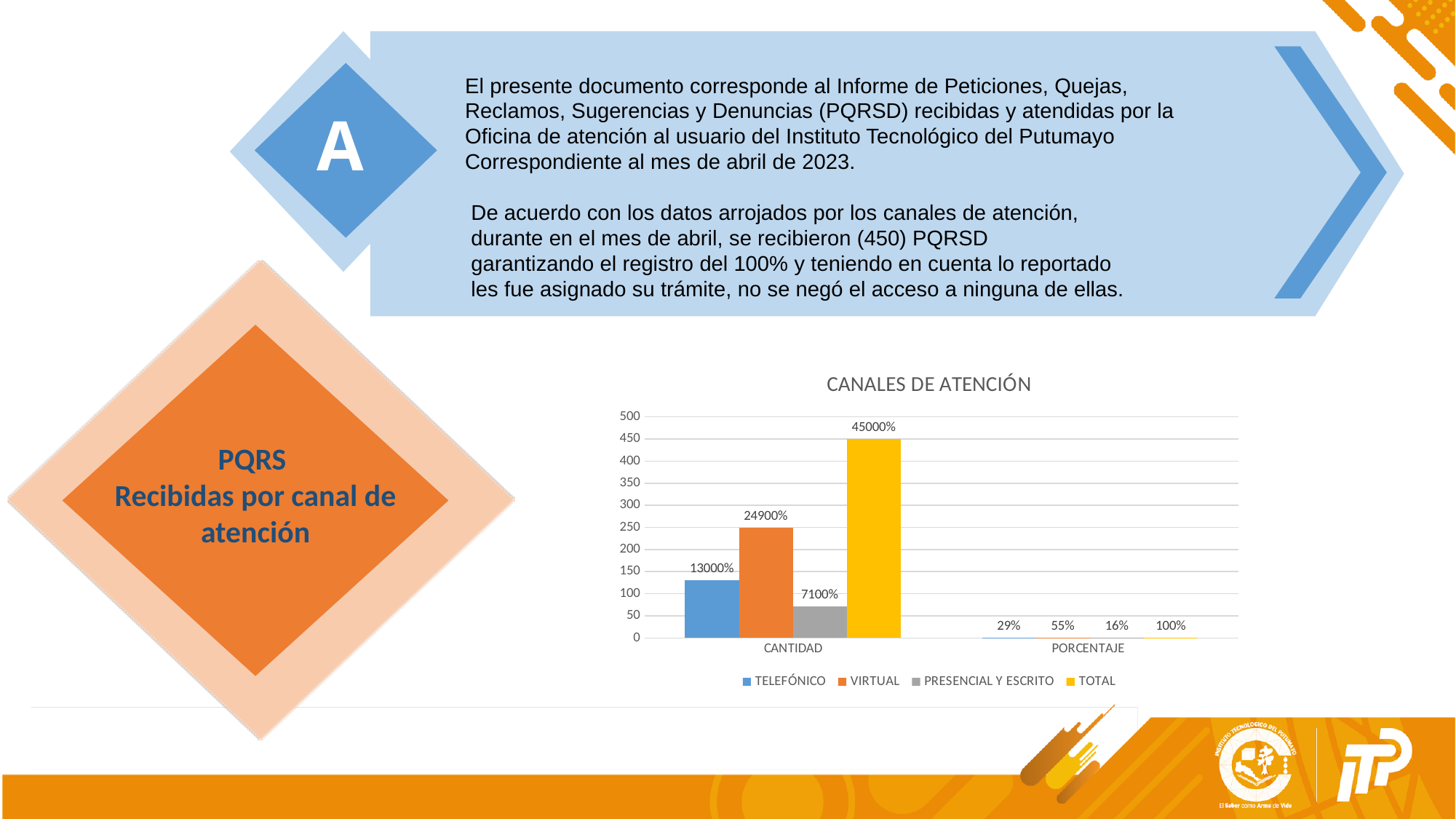
How many series does the chart legend list? 4 What is the data label for TOTAL in the CANTIDAD category? 45000% In the CANTIDAD category, which bar is taller: TELEFÓNICO or VIRTUAL? VIRTUAL What is the data label for VIRTUAL in the CANTIDAD category? 24900% What is the data label for VIRTUAL in the PORCENTAJE category? 55% What kind of chart is shown on the slide? bar chart What is the data label for TELEFÓNICO in the CANTIDAD category? 13000% What is the data label for PRESENCIAL Y ESCRITO in the CANTIDAD category? 7100% What is the title of the chart? CANALES DE ATENCIÓN What is the data label for PRESENCIAL Y ESCRITO in the PORCENTAJE category? 16% How many categories are shown on the x axis of the chart? 2 Which series has the lowest bar in the CANTIDAD category? PRESENCIAL Y ESCRITO